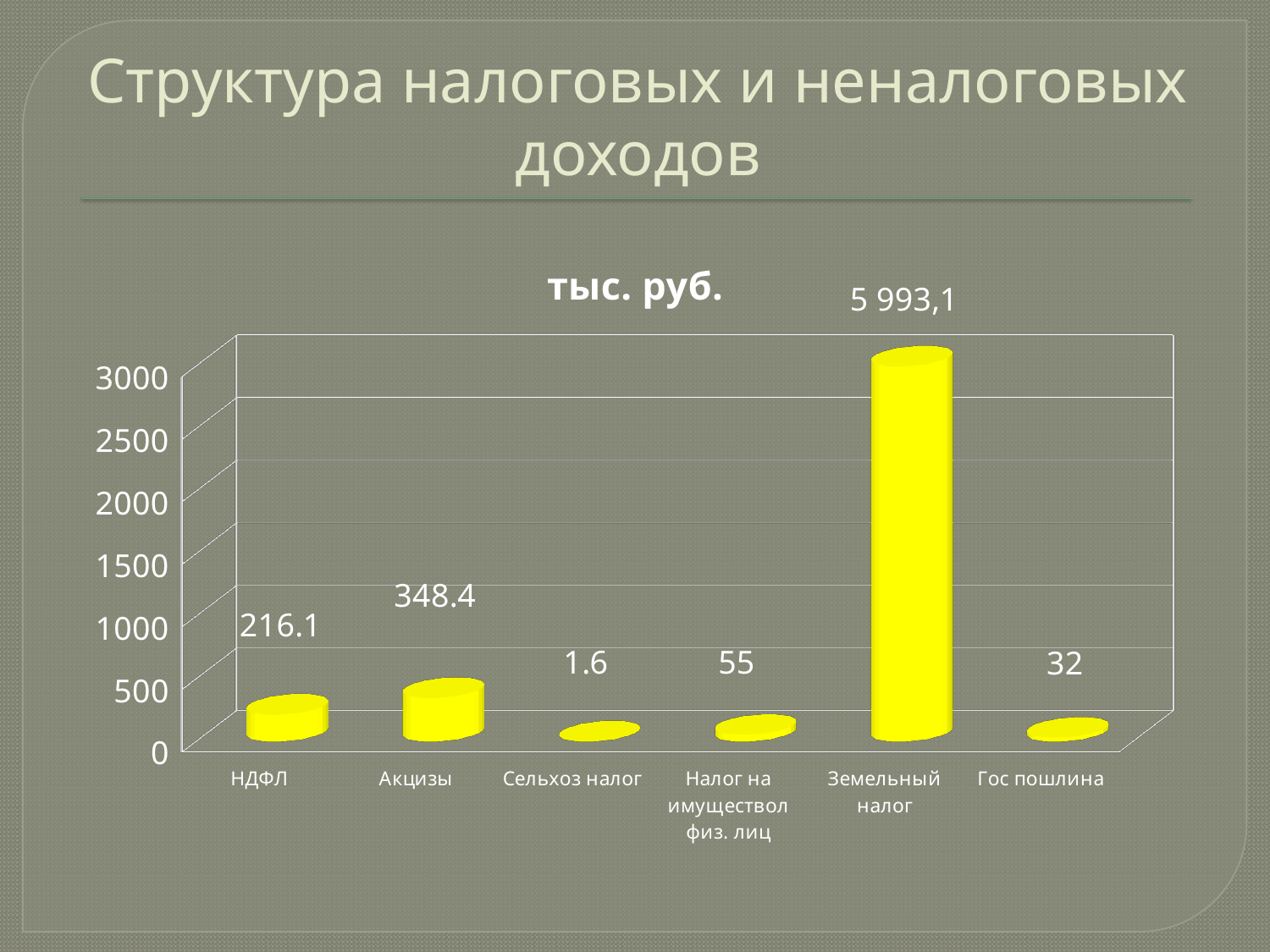
Which category has the lowest value? Сельхоз налог How many categories are shown on the x axis? 6 What is the value for Сельхоз налог? 1.6 What is the title of the chart? тыс. руб. What value is shown above the Земельный налог bar? 5 993,1 What kind of chart is shown on the slide? Bar chart What is the value for Акцизы? 348.4 What is the value for Гос пошлина? 32 What is the value for НДФЛ? 216.1 Which is larger, the value for Налог на имуществол физ. лиц or the value for Гос пошлина? Налог на имуществол физ. лиц Which category has the highest value? Земельный налог What is the difference between the values for Акцизы and НДФЛ? 132.3